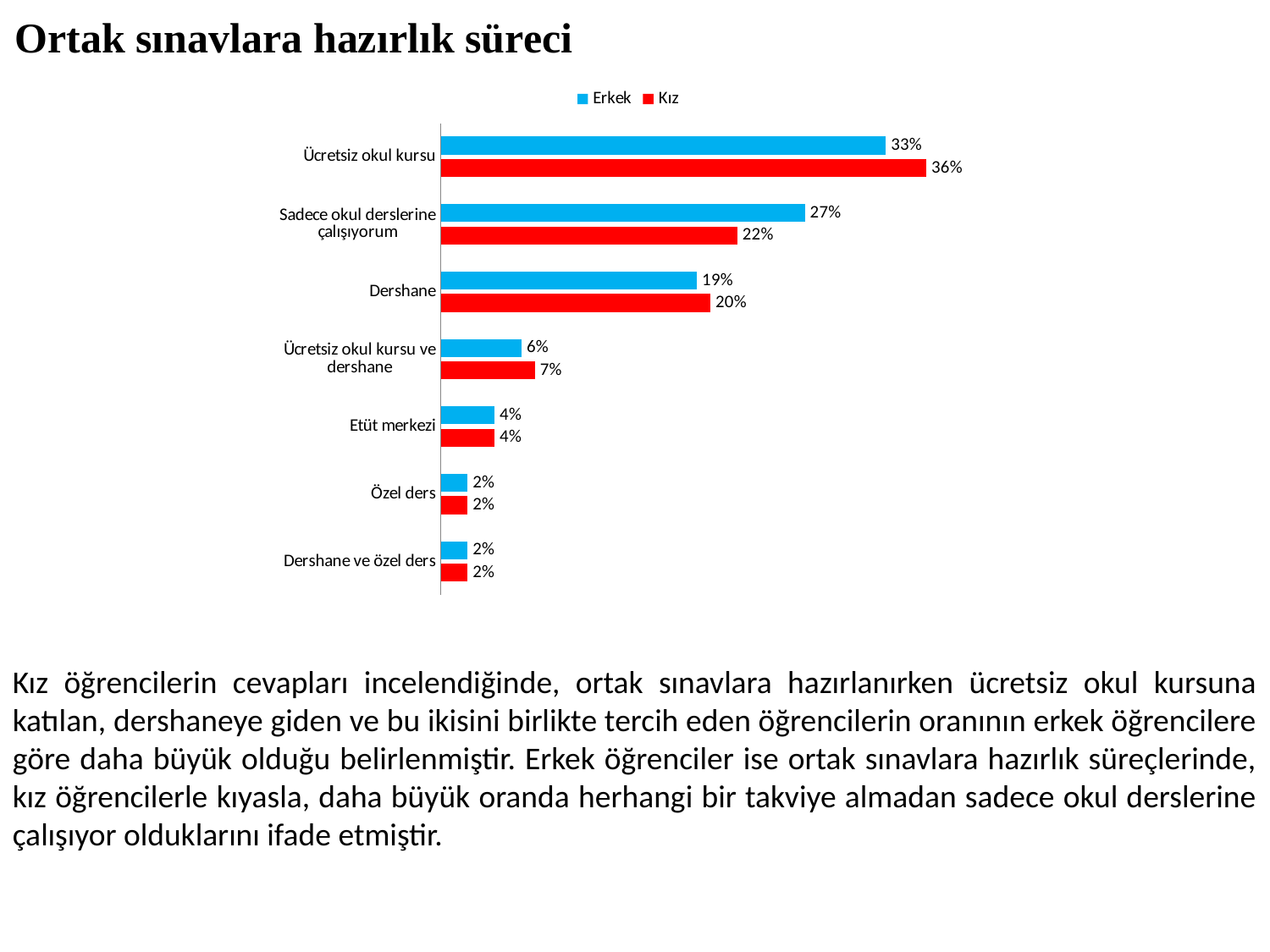
What is the Erkek value for Ücretsiz okul kursu ve dershane? 6% What is the difference between the Kız and Erkek values for Sadece okul derslerine çalışıyorum? 5% What kind of chart is shown on the slide? Bar chart Which category has the highest Kız value? Ücretsiz okul kursu What is the Kız value for Dershane? 20% How many categories are shown on the chart? 7 What is the Erkek value for Sadece okul derslerine çalışıyorum? 27% Which category has the highest Erkek value? Ücretsiz okul kursu What is the difference between the Kız and Erkek values for Ücretsiz okul kursu? 3% How many series does the legend list? 2 Which is larger for Dershane, the Erkek value or the Kız value? Kız What is the Kız value for Ücretsiz okul kursu? 36%